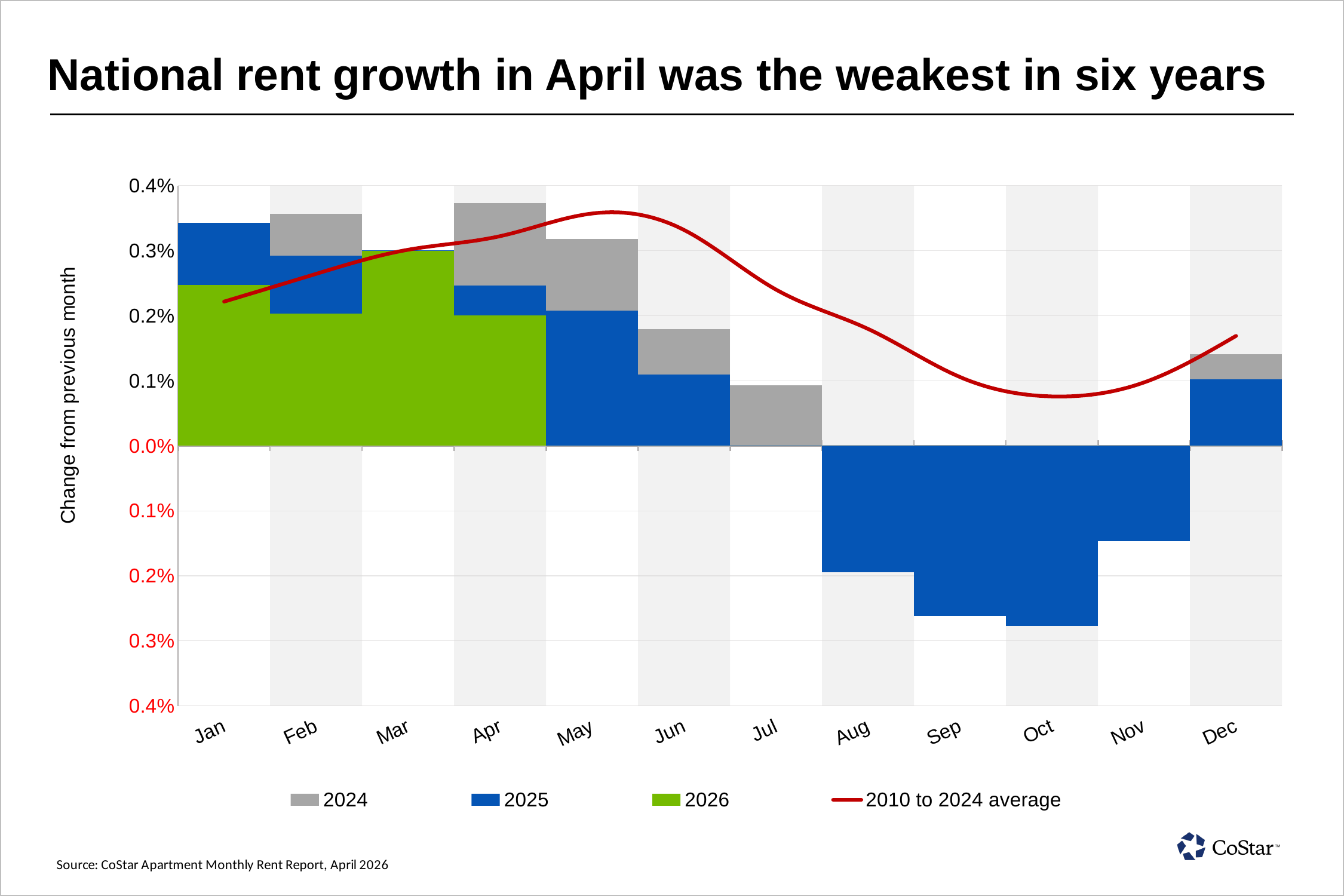
Is the 2025 value for Sep greater or less than -0.2%? less Is the 2025 value for Jun greater or less than 0.2%? less Is the 2025 value for Jan greater or less than 0.3%? greater How many months are shown along the x axis? 12 What kind of chart is shown on the slide? Bar chart with a line Which is larger for Apr, the 2024 value or the 2025 value? 2024 Which month has the highest 2025 bar? Jan How many series does the legend list? 4 Do the 2025 bars rise or fall from May to Oct? fall Which month has the lowest 2026 bar? Apr What does the red line in the chart represent, according to the legend? 2010 to 2024 average